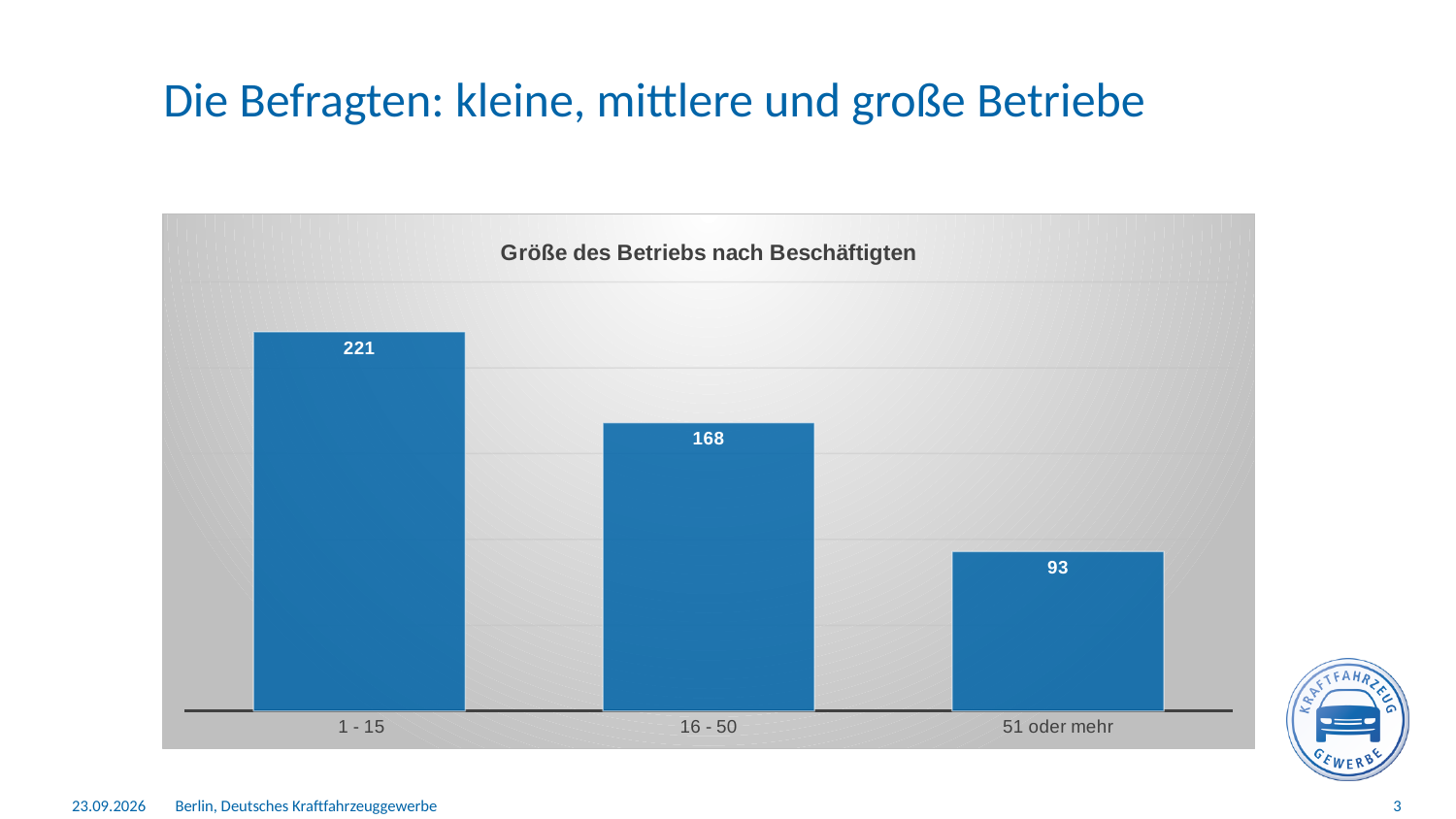
What is the title of the chart? Größe des Betriebs nach Beschäftigten Do the values rise or fall from left to right along the x axis? fall What is the value for the '16 - 50' category? 168 What is the value for the '51 oder mehr' category? 93 What is the difference between the values for '1 - 15' and '16 - 50'? 53 What kind of chart is shown on the slide? bar chart What is the value for the '1 - 15' category? 221 Which category has the highest value? 1 - 15 What is the difference between the values for '16 - 50' and '51 oder mehr'? 75 Which is larger, the value for '16 - 50' or the value for '51 oder mehr'? 16 - 50 Which category has the lowest value? 51 oder mehr How many categories are shown in the chart? 3